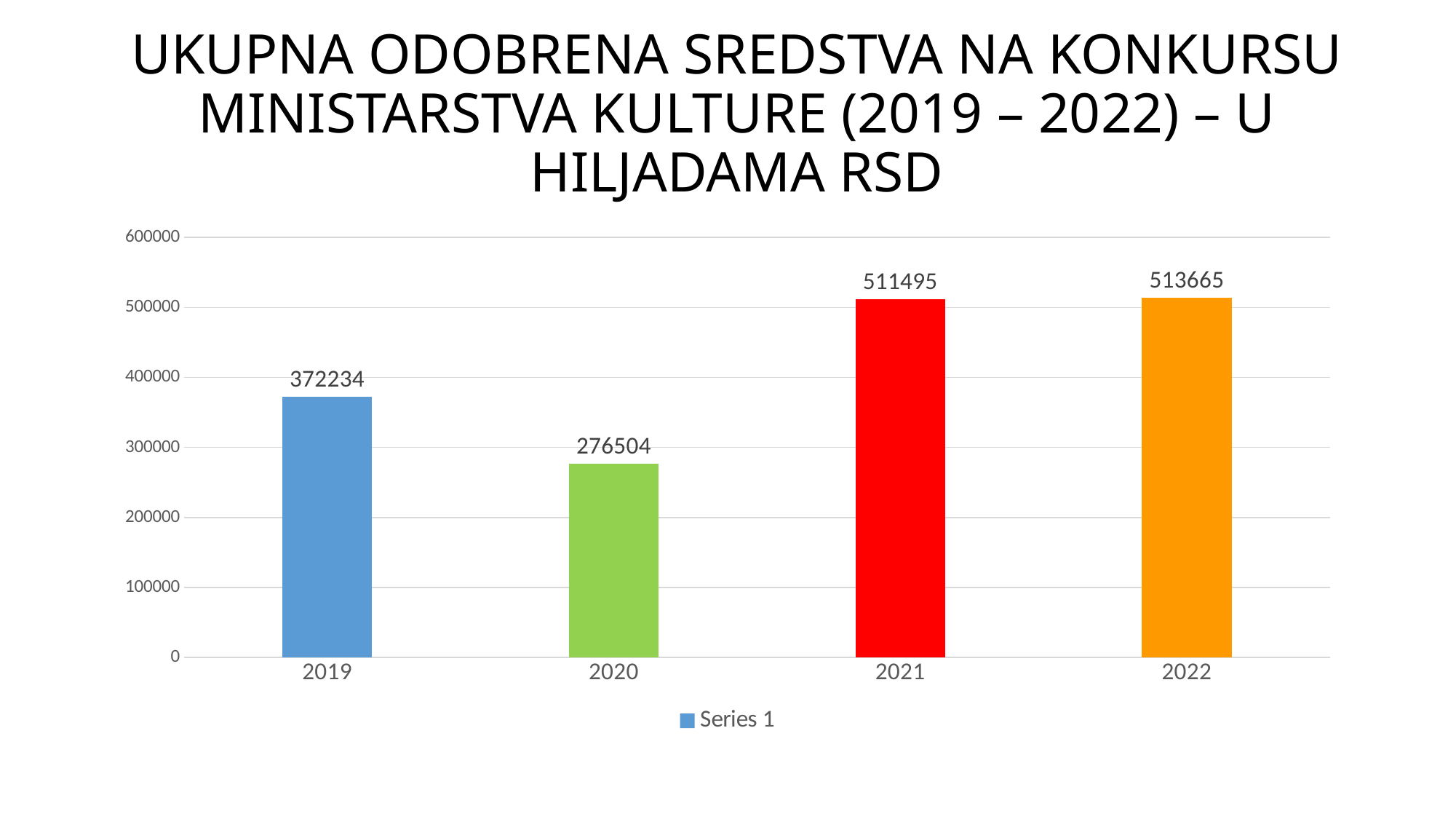
What is the difference between the values for 2019 and 2020? 95730 What is the value for 2019? 372234 What is the difference between the values for 2022 and 2021? 2170 What is the value for 2022? 513665 Which year has the lowest value? 2020 What kind of chart is shown on the slide? bar chart Which is larger, the value for 2019 or the value for 2021? 2021 Is the value for 2020 greater or less than 300000? less What is the value for 2020? 276504 How many years are shown on the x axis? 4 What is the value for 2021? 511495 Which year has the highest value? 2022